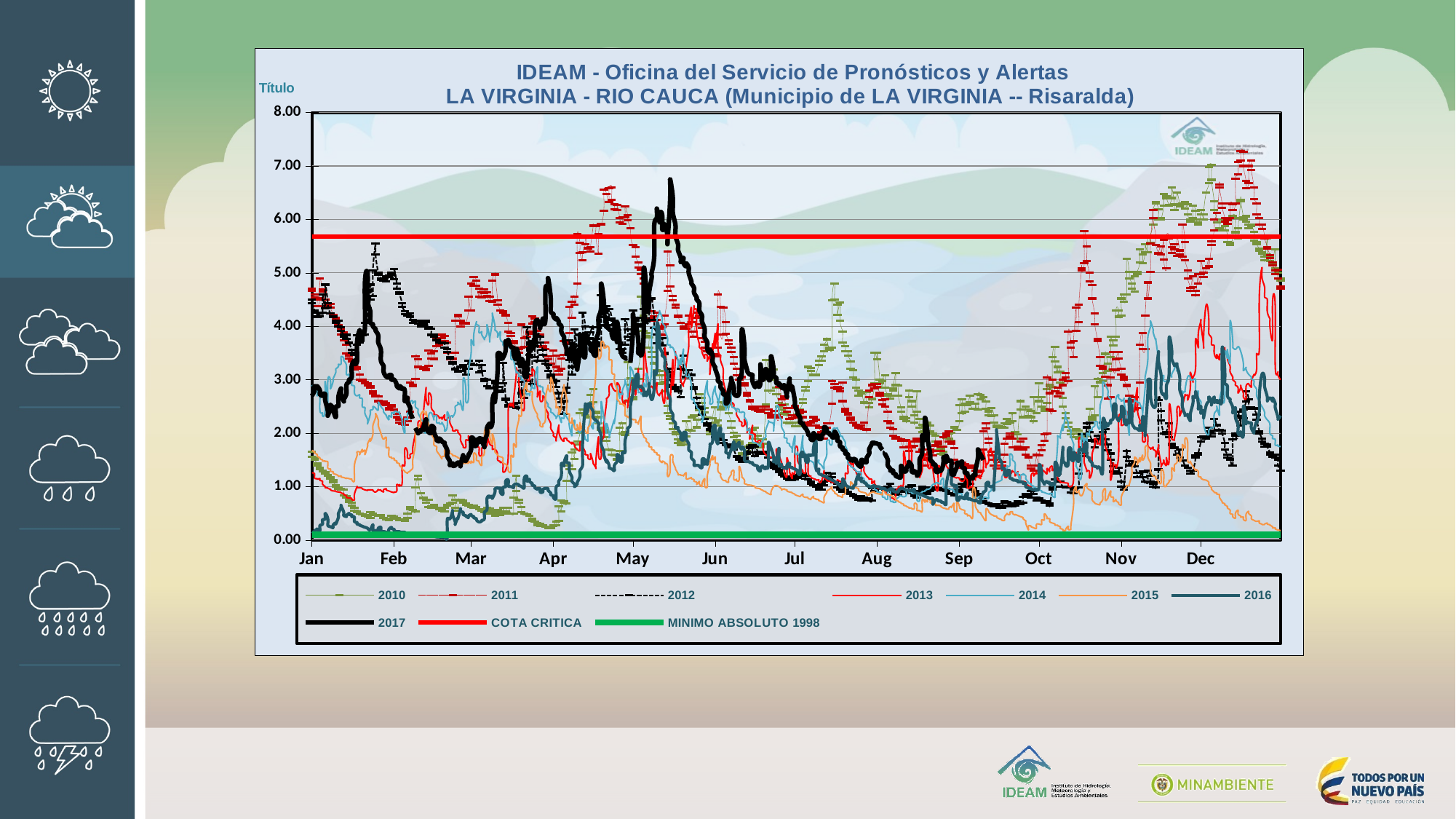
Which series is drawn as the green horizontal line near the bottom of the chart? MINIMO ABSOLUTO 1998 How many series does the chart legend list? 10 Is the MINIMO ABSOLUTO 1998 line greater or less than 1.00 on the y axis? less Is the value of the 2015 series at the end of December greater or less than 1.00? less Is the COTA CRITICA line greater or less than 5.00 on the y axis? greater What is the highest value labelled on the y axis of the chart? 8.00 Which series is drawn as the thick black line in the chart? 2017 What kind of chart is shown on the slide? line chart Does the 2017 series rise or fall from its mid-May peak to August? fall How many months are labelled along the x axis of the chart? 12